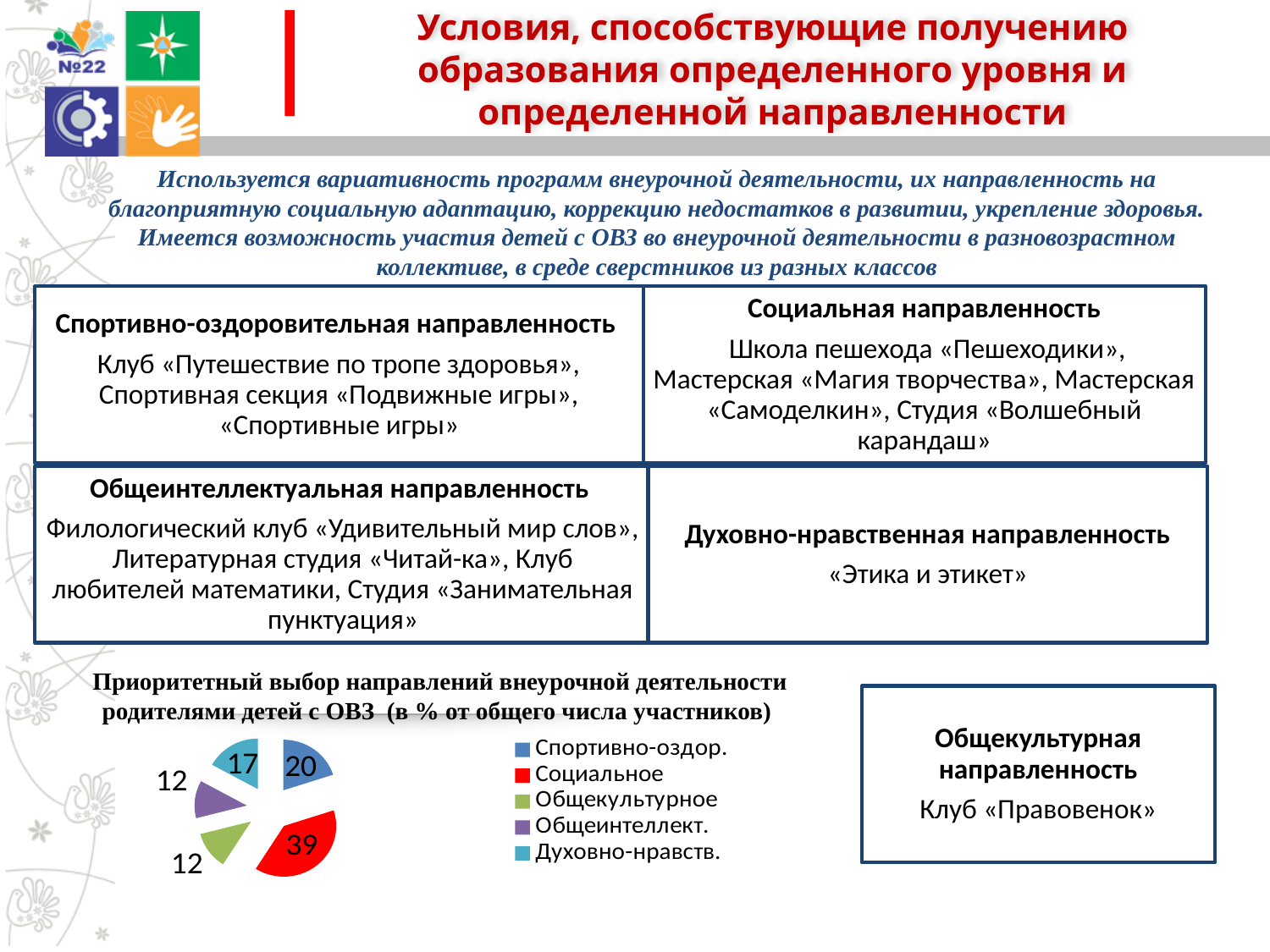
What is the value for Социальное in the pie chart? 39 What is the difference between the values for Спортивно-оздор. and Духовно-нравств.? 3 What is the value for Спортивно-оздор. in the pie chart? 20 What is the value for Общеинтеллект. in the pie chart? 12 How many entries does the legend of the pie chart list? 5 What colour is the slice for Социальное in the pie chart? red What kind of chart is shown on the slide? pie chart Which is larger, the value for Духовно-нравств. or the value for Общекультурное? Духовно-нравств. What is the value for Общекультурное in the pie chart? 12 Which category has the largest slice in the pie chart? Социальное What is the difference between the values for Социальное and Спортивно-оздор.? 19 What is the value for Духовно-нравств. in the pie chart? 17